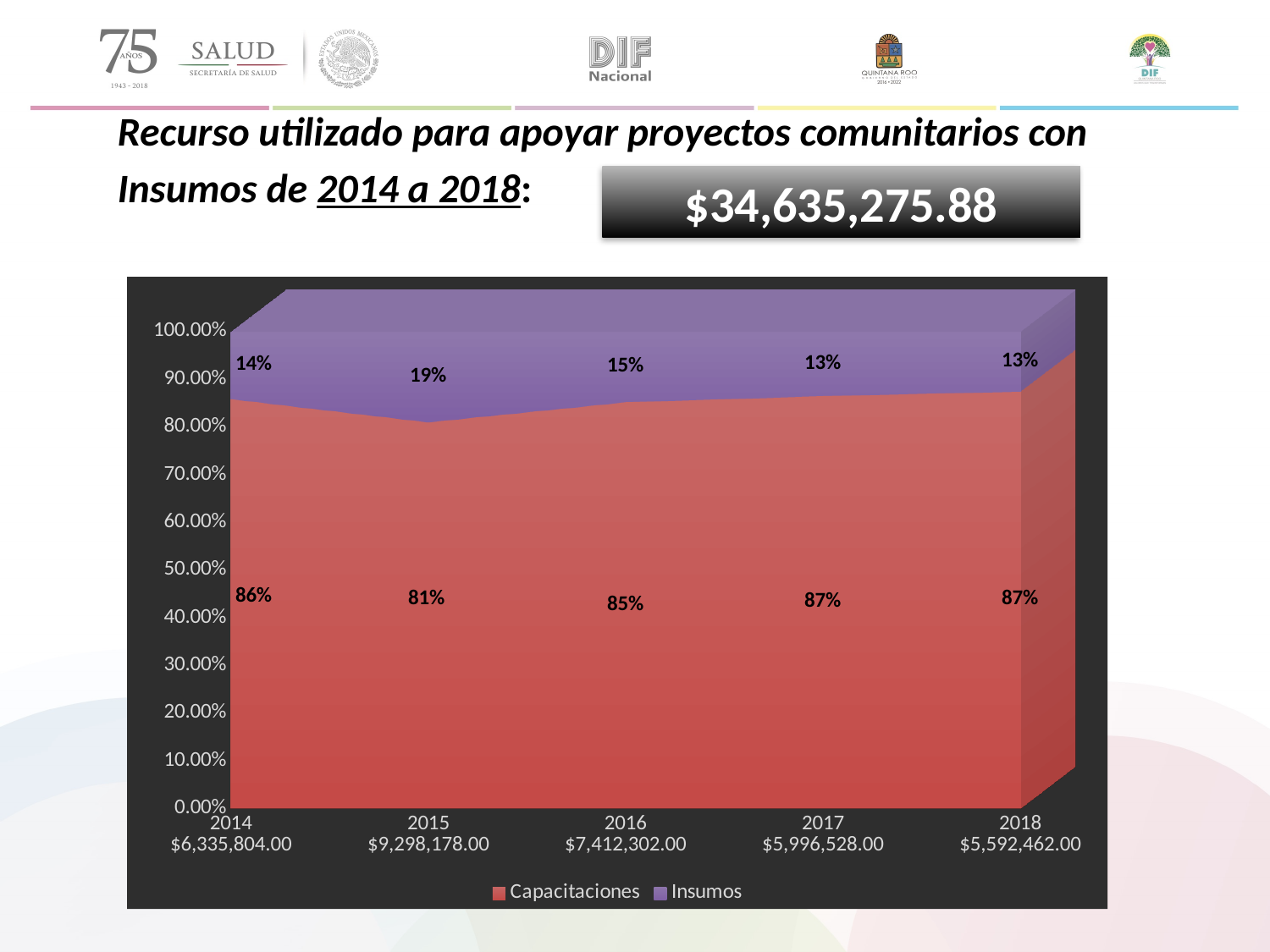
How many series does the chart legend list? 2 What kind of chart is shown on the slide? Stacked area chart Which is larger, the Insumos percentage in 2014 or in 2017? 2014 What is the Capacitaciones percentage for 2015? 81% What total amount is shown on the x axis label for 2015? $9,298,178.00 What is the difference between the Capacitaciones percentage in 2017 and in 2015? 6% In which year is the Insumos percentage highest? 2015 In which year is the Capacitaciones percentage lowest? 2015 What is the Insumos percentage for 2016? 15% What is the Insumos percentage for 2018? 13% How many years are shown along the x axis of the chart? 5 What are the two series named in the chart legend? Capacitaciones and Insumos